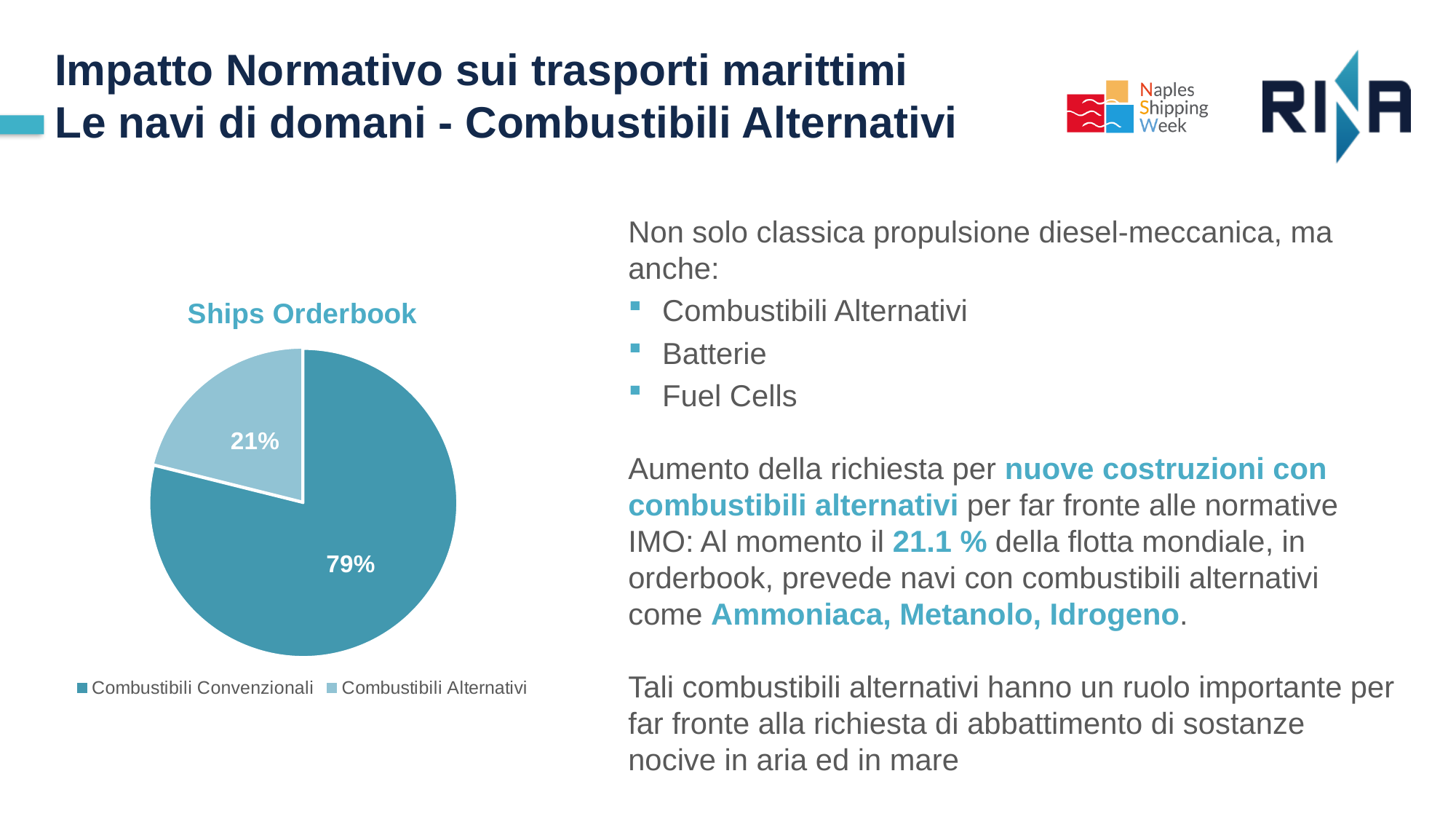
What share of the Ships Orderbook pie is Combustibili Alternativi? 21% Which slice of the Ships Orderbook pie is the smallest? Combustibili Alternativi Which legend entry is shown in the lighter blue colour in the Ships Orderbook chart? Combustibili Alternativi How many entries does the legend of the Ships Orderbook chart list? 2 What is the difference in percentage points between the Combustibili Convenzionali and Combustibili Alternativi slices? 58 percentage points What share of the Ships Orderbook pie is Combustibili Convenzionali? 79% Which slice of the Ships Orderbook pie is the largest? Combustibili Convenzionali What is the title of the chart? Ships Orderbook How many slices does the Ships Orderbook pie chart have? 2 Which is larger in the Ships Orderbook pie: Combustibili Convenzionali or Combustibili Alternativi? Combustibili Convenzionali What kind of chart is shown on the slide? Pie chart